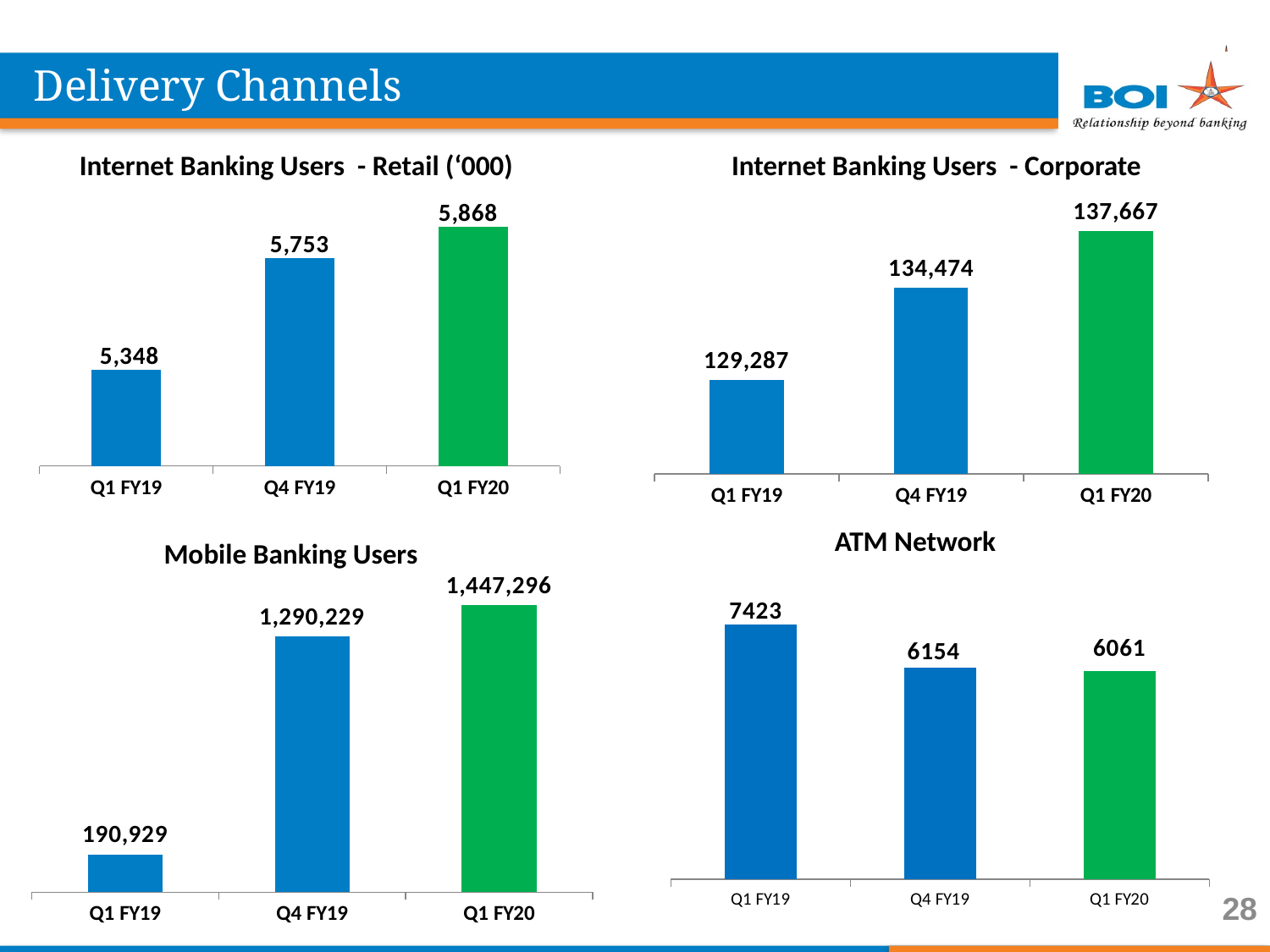
In the 'Internet Banking Users - Corporate' chart, do the values rise or fall from Q1 FY19 to Q1 FY20? rise In the 'ATM Network' chart, do the values rise or fall from Q1 FY19 to Q1 FY20? fall In the 'Internet Banking Users - Retail ('000)' chart, what is the difference between Q1 FY20 and Q1 FY19? 520 In the 'Mobile Banking Users' chart, what is the difference between Q1 FY20 and Q4 FY19? 157,067 In the 'ATM Network' chart, what is the value for Q1 FY19? 7423 In the 'Internet Banking Users - Retail ('000)' chart, which quarter has the lowest value? Q1 FY19 How many charts are shown on the slide, and what type are they? 4 bar charts In the 'ATM Network' chart, which quarter has the lowest value? Q1 FY20 In the 'Internet Banking Users - Corporate' chart, which quarter has the highest value? Q1 FY20 In the 'Internet Banking Users - Retail ('000)' chart, what is the value for Q1 FY20? 5,868 In the 'Mobile Banking Users' chart, what is the value for Q1 FY19? 190,929 In the 'Internet Banking Users - Corporate' chart, what is the value for Q4 FY19? 134,474